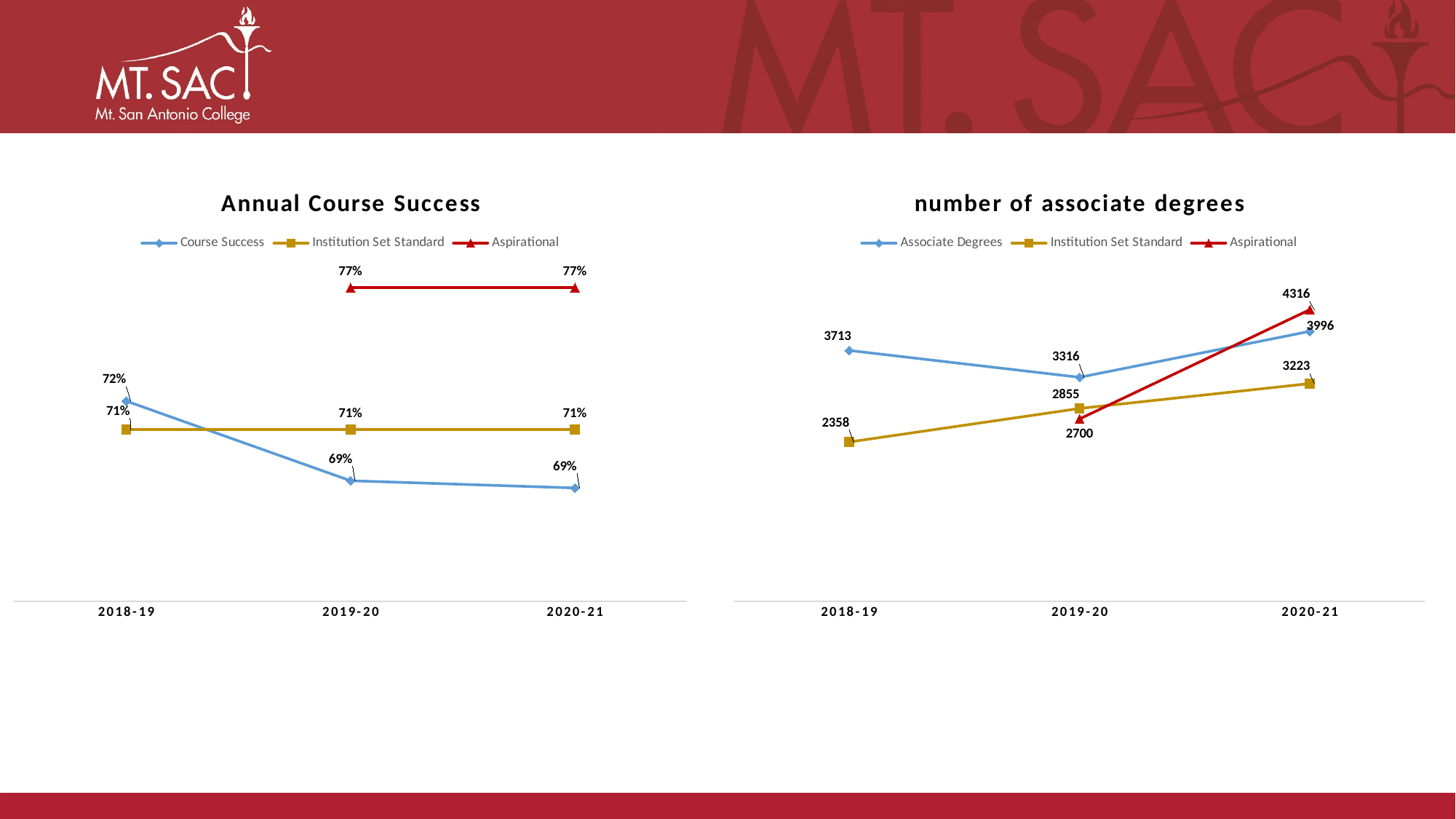
In the "number of associate degrees" chart, what is the Institution Set Standard value for 2018-19? 2358 In the "number of associate degrees" chart, what is the Associate Degrees value for 2019-20? 3316 In the "Annual Course Success" chart, what is the Course Success value for 2018-19? 72% In the "Annual Course Success" chart, how many series does the legend list? 3 In the "Annual Course Success" chart, what is the Aspirational value for 2020-21? 77% In the "number of associate degrees" chart, in which year is the Associate Degrees value highest? 2020-21 In the "number of associate degrees" chart, what is the difference between the Aspirational value and the Associate Degrees value for 2020-21? 320 What kind of chart is the "number of associate degrees" chart? line chart In the "Annual Course Success" chart, what is the Institution Set Standard value for 2019-20? 71% In the "Annual Course Success" chart, does the Course Success series rise or fall from 2018-19 to 2020-21? fall In the "number of associate degrees" chart, which is larger for 2019-20: the Institution Set Standard value or the Aspirational value? Institution Set Standard In the "Annual Course Success" chart, what is the difference between the Aspirational value and the Course Success value for 2020-21? 8%